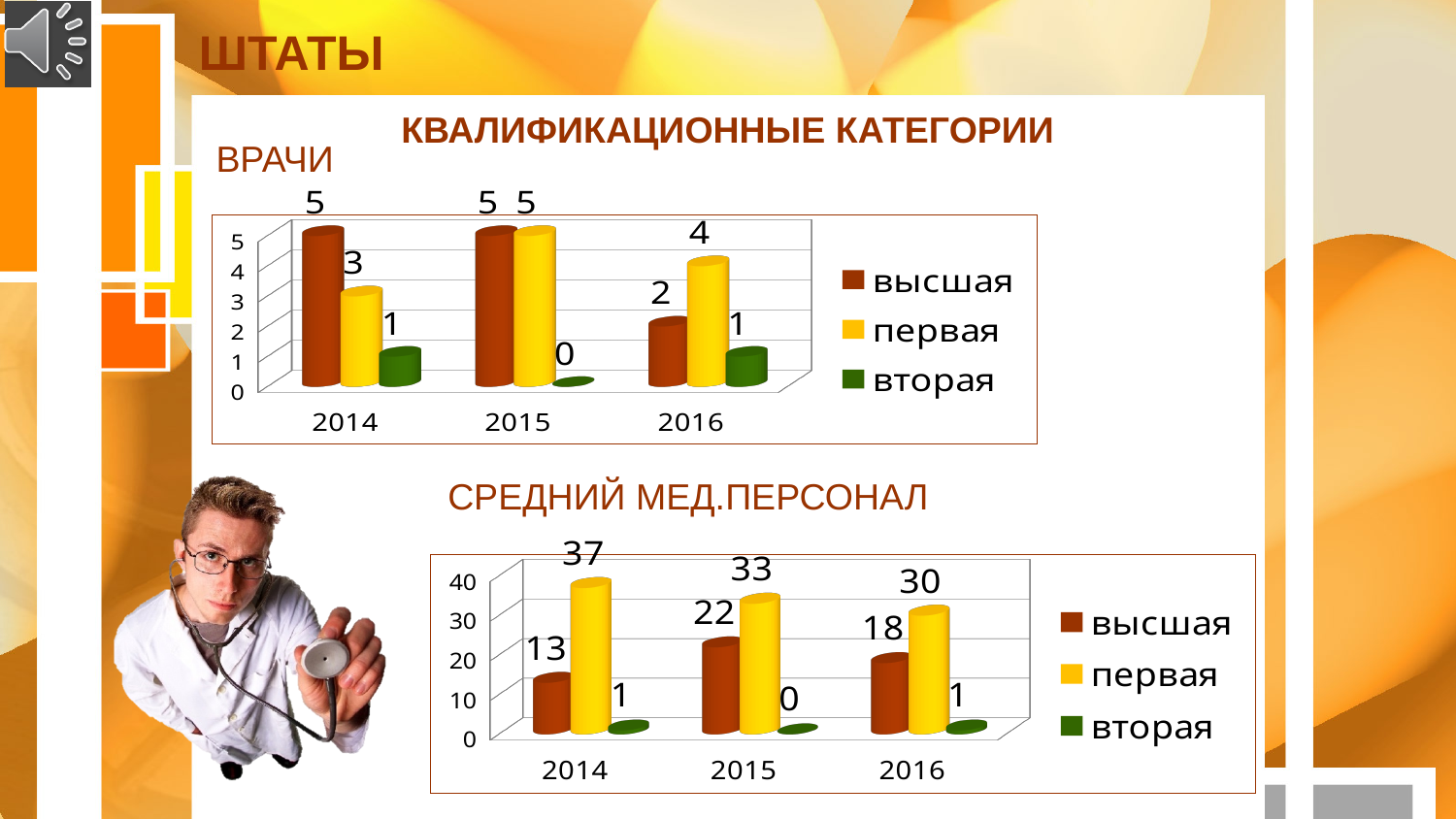
In the ВРАЧИ chart, how many series does the legend list? 3 In the ВРАЧИ chart, what is the difference between высшая and первая in 2014? 2 In the СРЕДНИЙ МЕД.ПЕРСОНАЛ chart, does the value for первая rise or fall from 2014 to 2016? fall In the СРЕДНИЙ МЕД.ПЕРСОНАЛ chart, which year has the highest value for первая? 2014 In the СРЕДНИЙ МЕД.ПЕРСОНАЛ chart, what is the value for высшая in 2015? 22 In the ВРАЧИ chart, what is the value for первая in 2016? 4 In the ВРАЧИ chart, what is the value for вторая in 2015? 0 In the СРЕДНИЙ МЕД.ПЕРСОНАЛ chart, what is the difference between первая and высшая in 2016? 12 In the СРЕДНИЙ МЕД.ПЕРСОНАЛ chart, which year has the lowest value for высшая? 2014 In the СРЕДНИЙ МЕД.ПЕРСОНАЛ chart, what is the value for первая in 2014? 37 In the ВРАЧИ chart, what is the value for высшая in 2014? 5 What kind of chart is the СРЕДНИЙ МЕД.ПЕРСОНАЛ chart? bar chart